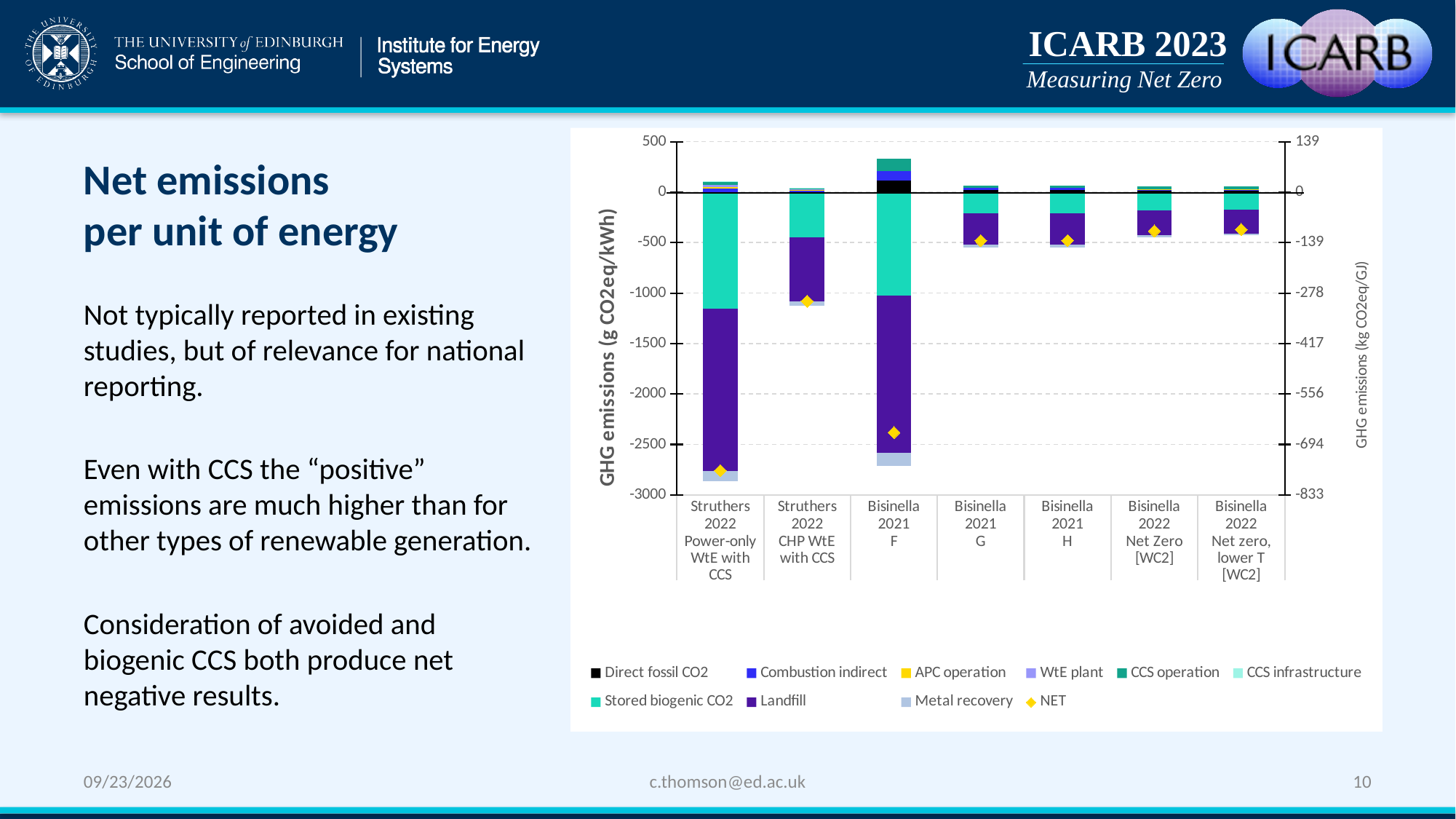
Is the NET value for Bisinella 2021 F greater or less than -2000? less How many categories (scenarios) are shown along the x axis of the chart? 7 Which series is plotted as yellow diamond markers in the chart? NET Is the NET value for Struthers 2022 CHP WtE with CCS greater or less than -500? less Which category has the larger Landfill segment: Bisinella 2021 F or Bisinella 2021 G? Bisinella 2021 F Which category has the lowest NET value? Struthers 2022 Power-only WtE with CCS What kind of chart is shown on the slide? Stacked bar chart How many series does the chart's legend list? 10 Is the NET value for Bisinella 2022 Net Zero [WC2] greater or less than -500? greater What is the label of the left-hand y axis of the chart? GHG emissions (g CO2eq/kWh) Which has the higher NET value: Bisinella 2021 G or Struthers 2022 CHP WtE with CCS? Bisinella 2021 G